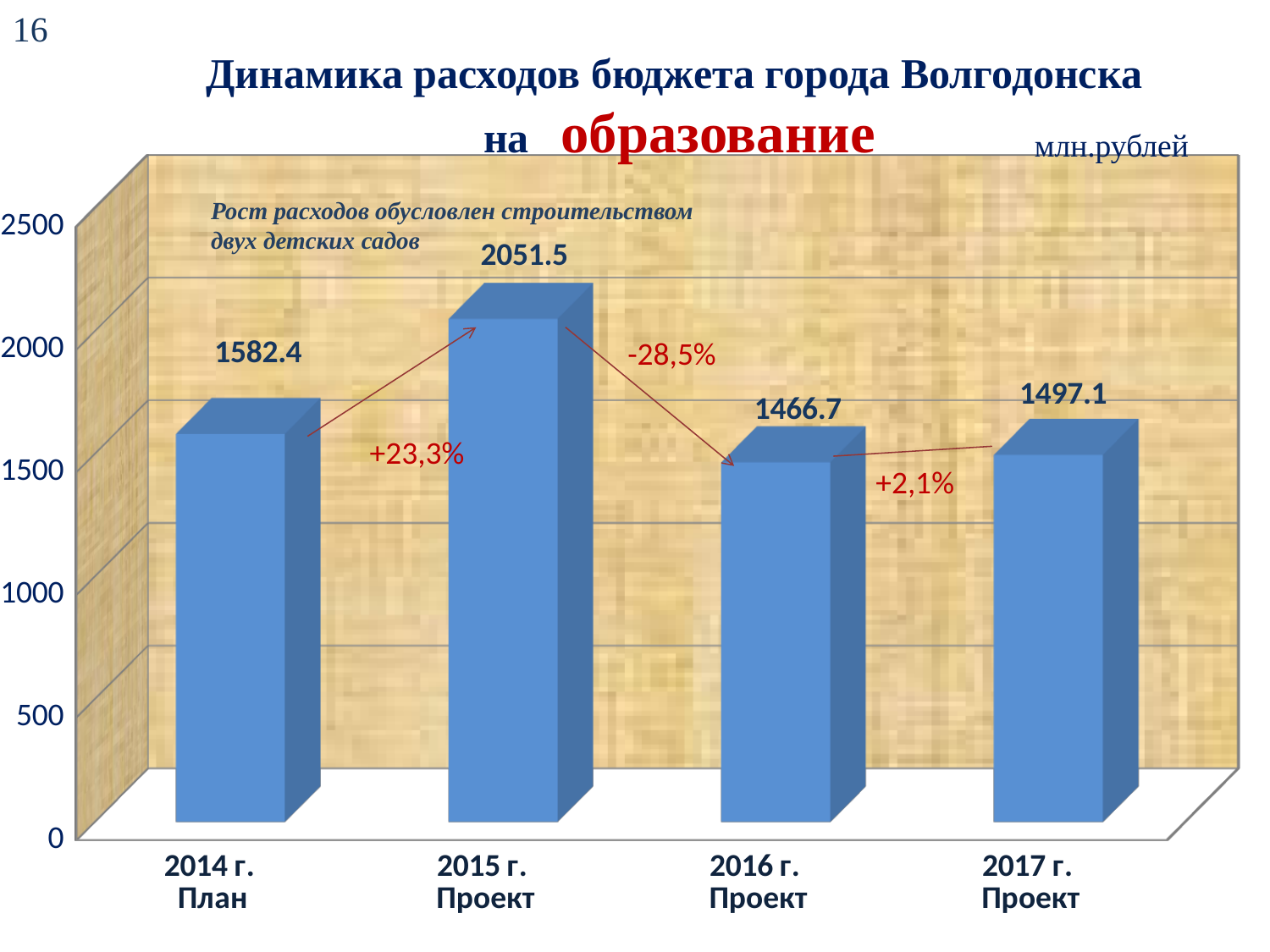
What is the value for 2014 г. План? 1582.4 What is the value for 2017 г. Проект? 1497.1 Which is larger, the value for 2016 г. Проект or 2017 г. Проект? 2017 г. Проект Which category has the lowest value? 2016 г. Проект What percentage change is annotated between 2015 г. Проект and 2016 г. Проект? -28,5% What is the difference between the values for 2015 г. Проект and 2014 г. План? 469.1 What is the value for 2015 г. Проект? 2051.5 Which category has the highest value? 2015 г. Проект How many categories are shown on the x axis? 4 What is the value for 2016 г. Проект? 1466.7 What is the difference between the values for 2017 г. Проект and 2016 г. Проект? 30.4 What kind of chart is shown on the slide? Bar chart